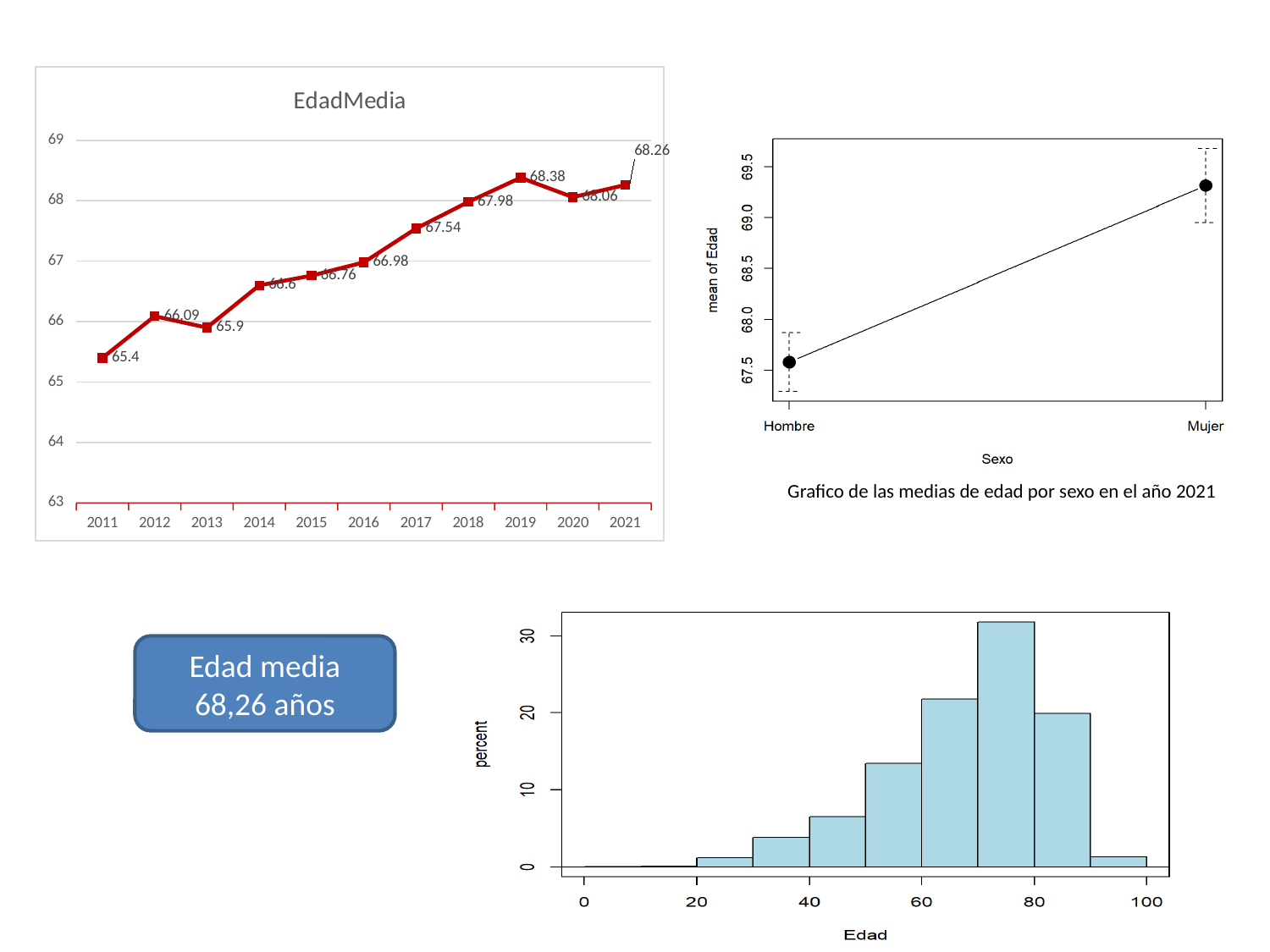
In the chart 'Grafico de las medias de edad por sexo en el año 2021', is the mean age for Hombre greater or less than 68.0? less In the EdadMedia chart, what is the difference between the values for 2021 and 2011? 2.86 In the EdadMedia chart, which year has the lowest value? 2011 In the EdadMedia chart, how many years are plotted? 11 What kind of chart is the EdadMedia chart? Line chart In the histogram of Edad at the bottom of the slide, is the percent for the 70 to 80 age bin greater or less than 30? greater In the EdadMedia chart, what is the value for 2019? 68.38 In the EdadMedia chart, which year has the highest value? 2019 In the EdadMedia chart, what is the value for 2011? 65.4 In the EdadMedia chart, which is larger, the value for 2020 or the value for 2021? 2021 In the chart 'Grafico de las medias de edad por sexo en el año 2021', which category has the higher mean age, Hombre or Mujer? Mujer In the EdadMedia chart, do the values generally rise or fall from 2011 to 2021? Rise